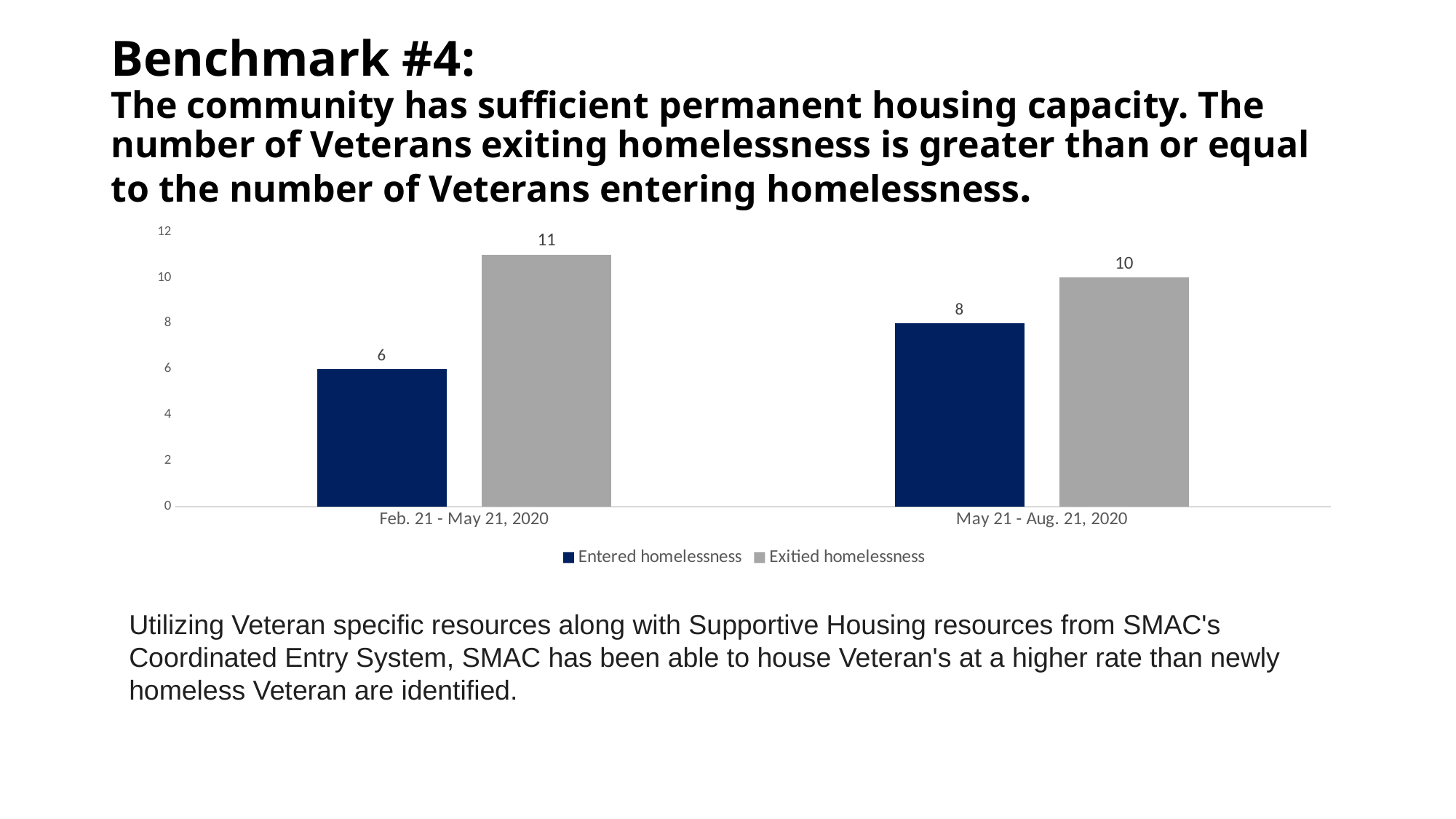
What is the difference between Exitied homelessness and Entered homelessness in the Feb. 21 - May 21, 2020 period? 5 How many Veterans exited homelessness in the Feb. 21 - May 21, 2020 period? 11 Which period has the lower value for Entered homelessness? Feb. 21 - May 21, 2020 In the May 21 - Aug. 21, 2020 period, which is larger: Entered homelessness or Exitied homelessness? Exitied homelessness How many Veterans entered homelessness in the May 21 - Aug. 21, 2020 period? 8 What is the difference between Exitied homelessness and Entered homelessness in the May 21 - Aug. 21, 2020 period? 2 How many series does the chart legend list? 2 What kind of chart is shown on the slide? Bar chart How many Veterans exited homelessness in the May 21 - Aug. 21, 2020 period? 10 How many Veterans entered homelessness in the Feb. 21 - May 21, 2020 period? 6 How many time periods are shown on the x axis of the chart? 2 Which period has the higher value for Exitied homelessness? Feb. 21 - May 21, 2020